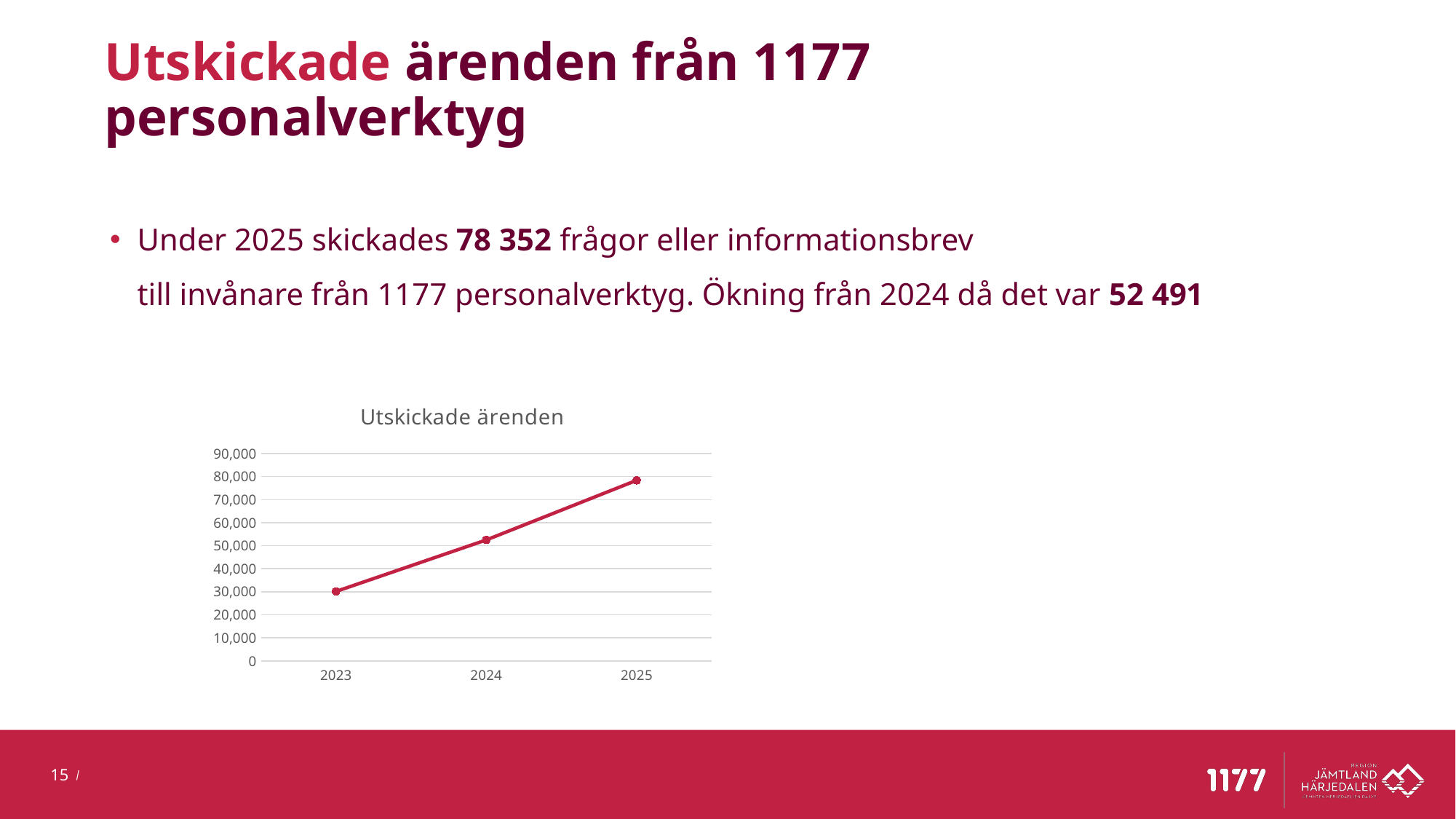
According to the slide, how many ärenden were sent in 2024? 52 491 What is the title of the chart? Utskickade ärenden Do the values in the chart rise or fall from 2023 to 2025? rise Is the value for 2025 greater or less than 70,000? greater Which year has the lowest value in the chart? 2023 What kind of chart is shown on the slide? line chart According to the slide, how many ärenden were sent in 2025? 78 352 Which year has the highest value in the chart? 2025 Is the value for 2024 greater or less than 60,000? less How many years are plotted on the x axis of the chart? 3 Which year has the larger value, 2024 or 2025? 2025 Is the value for 2023 greater or less than 40,000? less